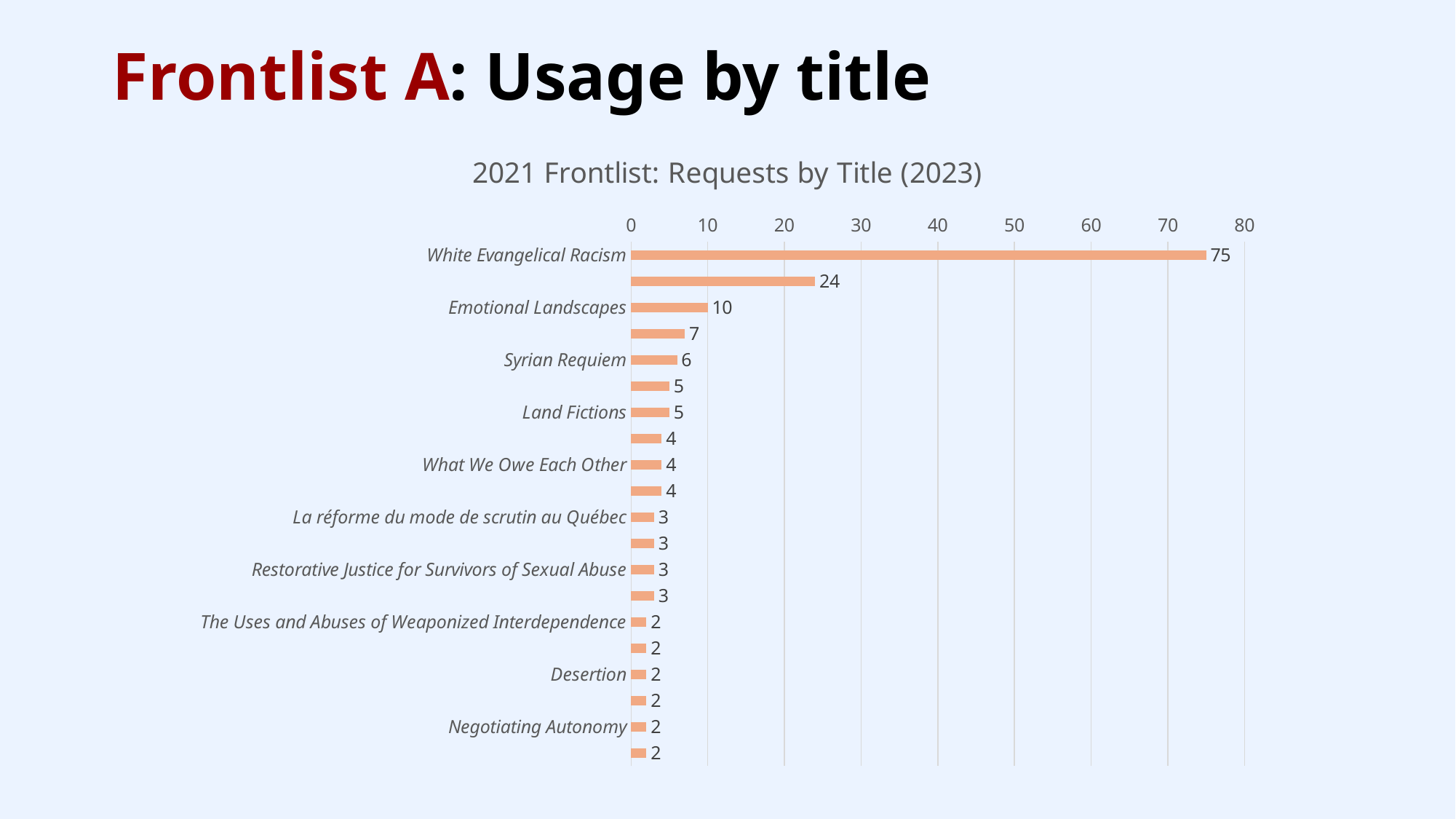
What is the value for Land Fictions? 5 What is the title of the chart? 2021 Frontlist: Requests by Title (2023) What is the difference in requests between White Evangelical Racism and Emotional Landscapes? 65 How many requests are shown for Syrian Requiem? 6 What is the value for Restorative Justice for Survivors of Sexual Abuse? 3 How many bars are plotted in the chart? 20 Which title has the highest number of requests? White Evangelical Racism What is the value shown for Emotional Landscapes? 10 How many requests does White Evangelical Racism have? 75 Which has more requests, Syrian Requiem or Land Fictions? Syrian Requiem What type of chart is shown on the slide? Bar chart Is the value for White Evangelical Racism greater or less than 70? greater